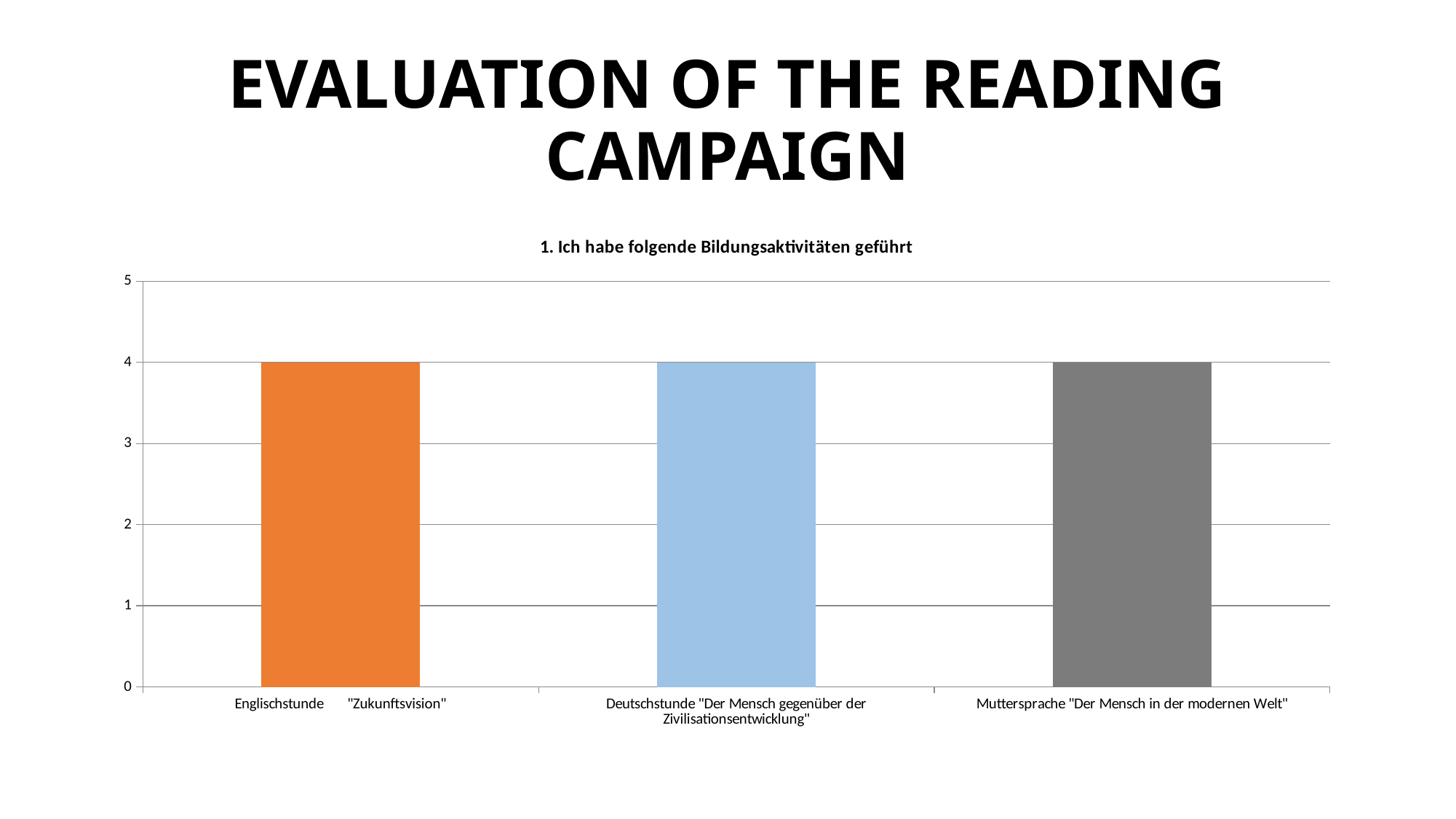
What is the value for Deutschstunde "Der Mensch gegenüber der Zivilisationsentwicklung"? 4 What is the title of the chart? 1. Ich habe folgende Bildungsaktivitäten geführt How many categories are shown on the chart? 3 Is the value for Deutschstunde "Der Mensch gegenüber der Zivilisationsentwicklung" greater or less than 2? greater What kind of chart is shown on the slide? bar chart What is the value for Englischstunde "Zukunftsvision"? 4 What colour is the bar for Englischstunde "Zukunftsvision"? orange What is the difference between the value for Englischstunde "Zukunftsvision" and the value for Muttersprache "Der Mensch in der modernen Welt"? 0 Is the value for Muttersprache "Der Mensch in der modernen Welt" greater or less than 5? less Do the values rise, fall, or stay the same across the categories from left to right? stay the same Is the value for Englischstunde "Zukunftsvision" greater or less than 3? greater What is the value for Muttersprache "Der Mensch in der modernen Welt"? 4